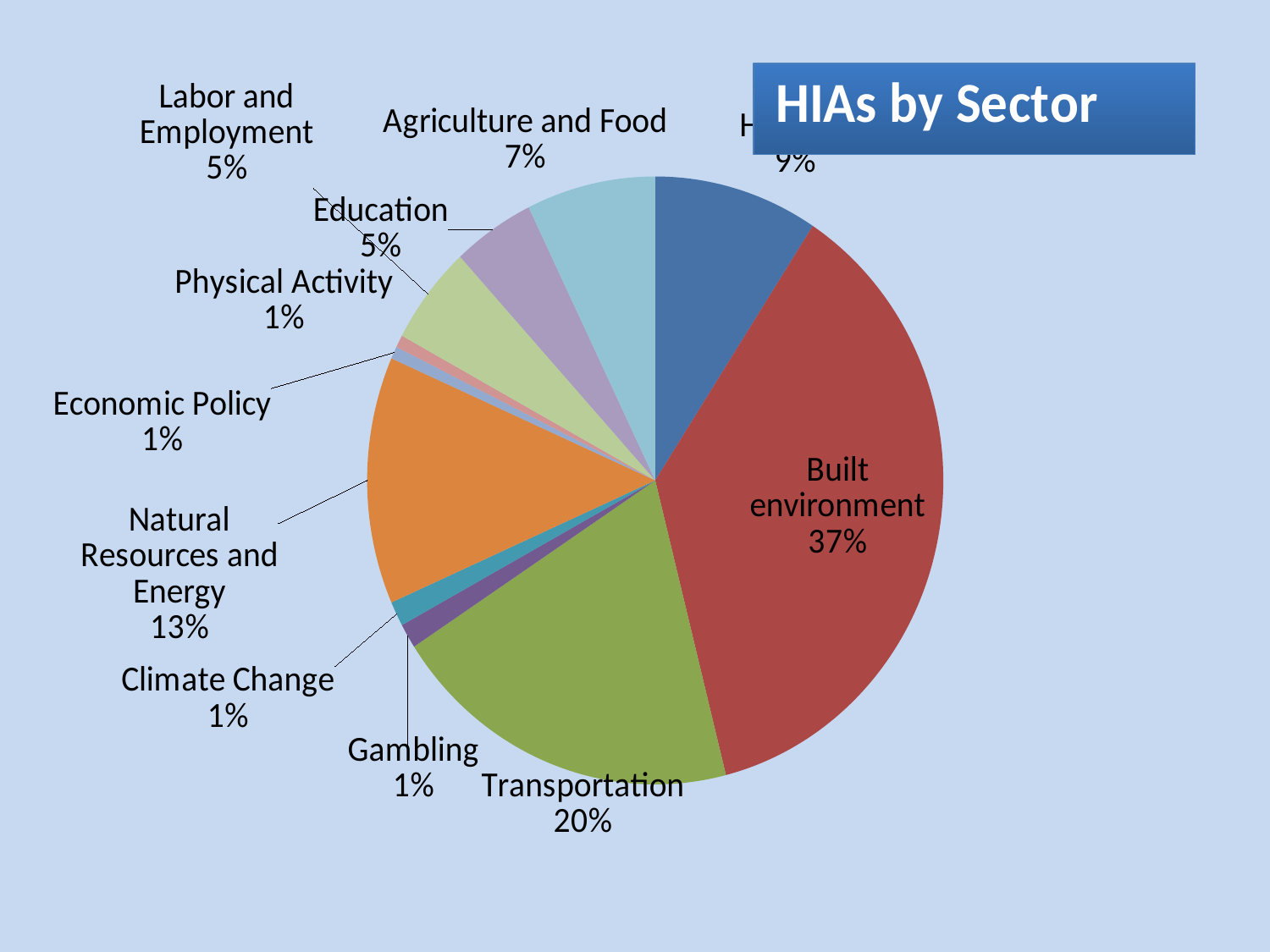
What percentage is shown for Agriculture and Food? 7% What share does Natural Resources and Energy have? 13% What is the title of the chart? HIAs by Sector What percentage of HIAs is in the Transportation sector? 20% What share of HIAs is in the Gambling sector? 1% What share does Labor and Employment have? 5% Which has a larger share, Natural Resources and Energy or Agriculture and Food? Natural Resources and Energy What kind of chart is shown on the slide? pie chart What is the combined share of Education and Labor and Employment? 10% What share of HIAs is in the Built environment sector? 37% What is the difference in percentage points between Built environment and Transportation? 17 Which sector has the largest share of HIAs? Built environment